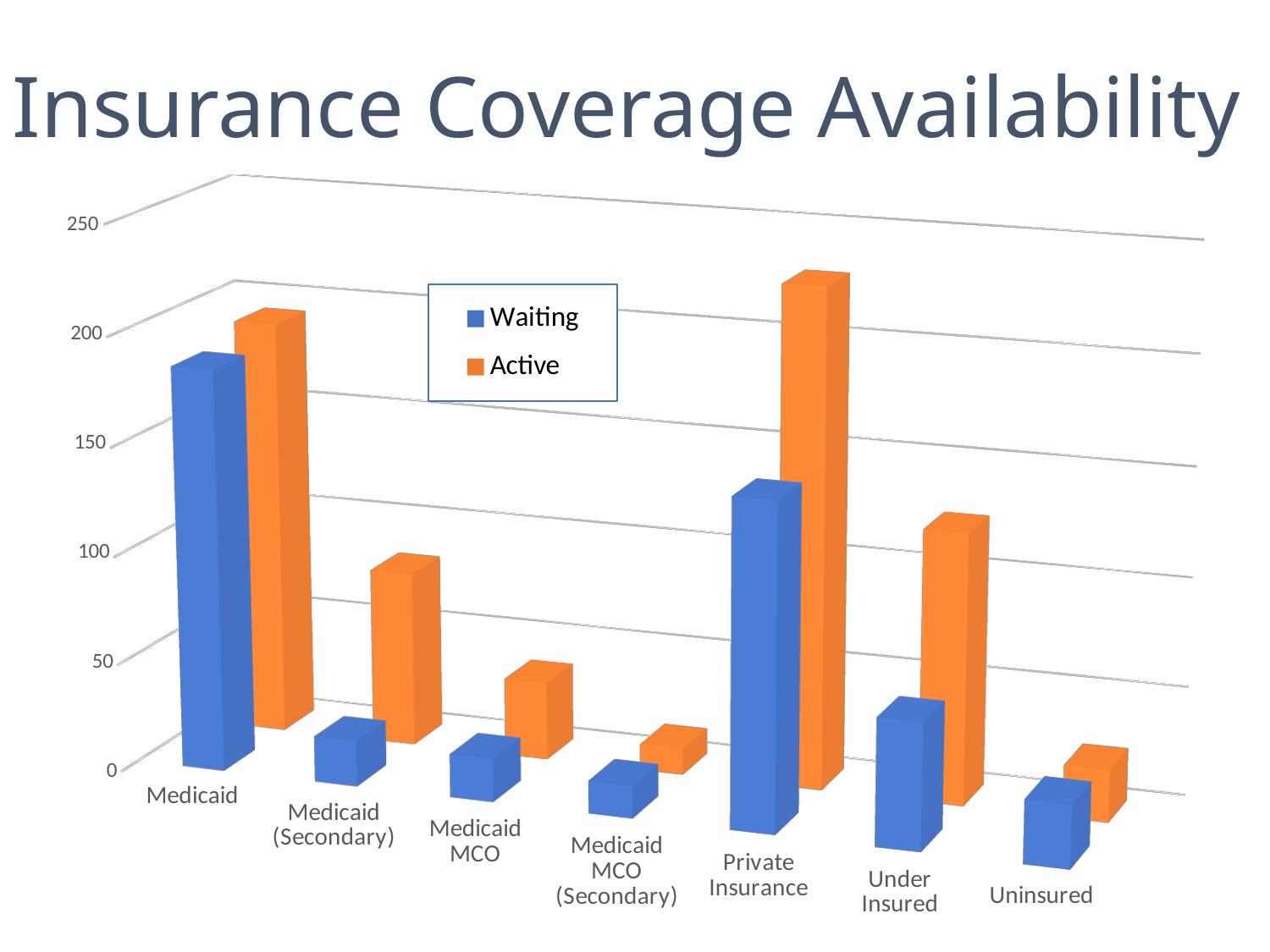
Is the Waiting value for Uninsured greater or less than 50? less Is the Active value for Medicaid (Secondary) greater or less than 100? less Which category has the highest Active value? Private Insurance What is the title of the chart? Insurance Coverage Availability How many insurance categories are shown on the x axis? 7 Which is larger, the Waiting value for Medicaid or the Waiting value for Private Insurance? Medicaid How many series does the legend list? 2 What type of chart is shown on the slide? bar chart Is the Waiting value for Medicaid greater or less than 150? greater Which category has the highest Waiting value? Medicaid